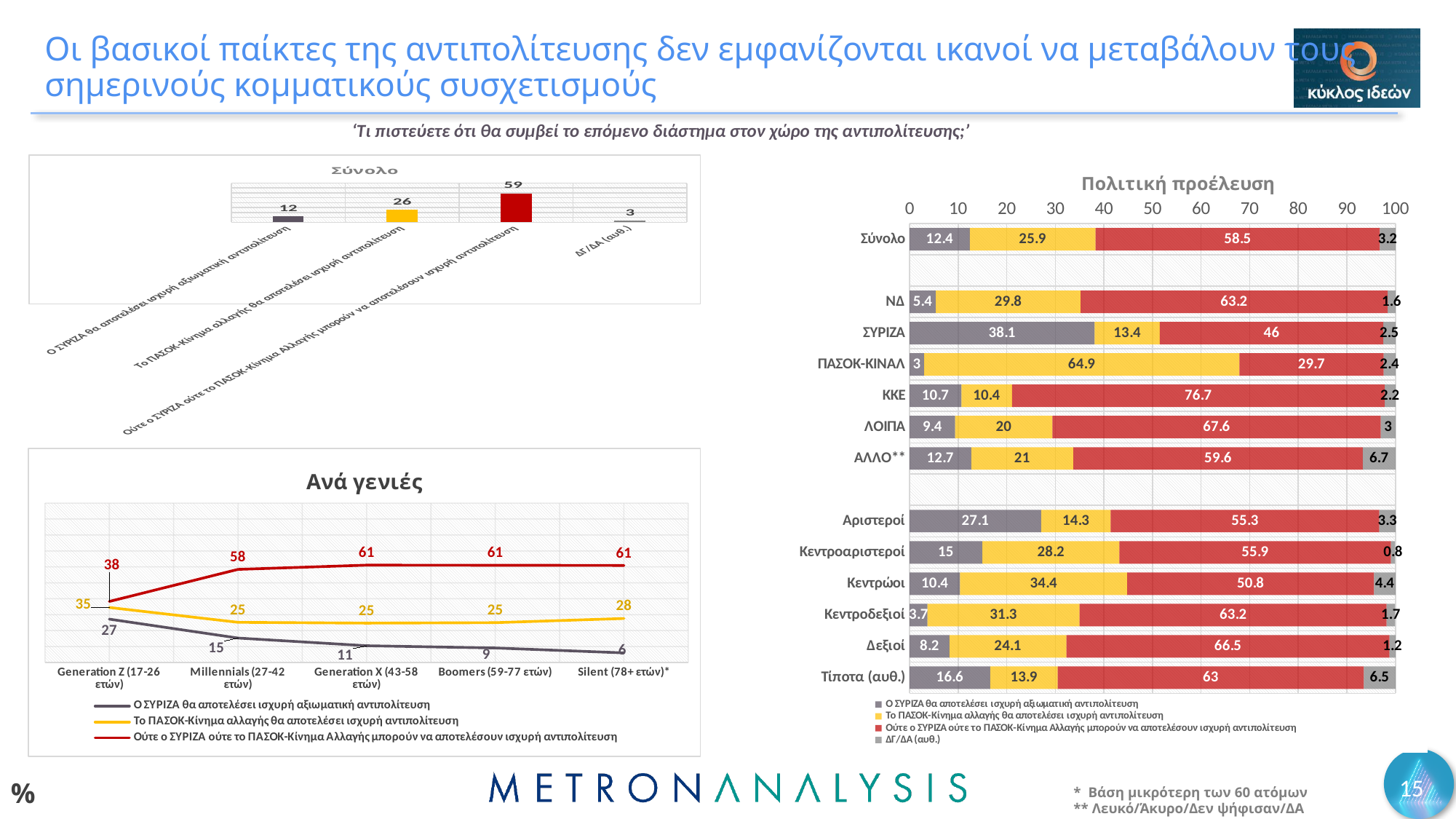
In the 'Ανά γενιές' chart, what is the difference between the red series and the yellow series for Silent (78+ ετών)? 33 In the 'Πολιτική προέλευση' chart, which has the larger yellow segment, ΠΑΣΟΚ-ΚΙΝΑΛ or ΝΔ? ΠΑΣΟΚ-ΚΙΝΑΛ In the 'Σύνολο' chart, what is the value for ΔΓ/ΔΑ (αυθ.)? 3 In the 'Σύνολο' chart, what kind of chart is it? Bar chart In the 'Σύνολο' chart, which category has the highest value? Ούτε ο ΣΥΡΙΖΑ ούτε το ΠΑΣΟΚ-Κίνημα Αλλαγής μπορούν να αποτελέσουν ισχυρή αντιπολίτευση In the 'Πολιτική προέλευση' chart, what is the value of the red segment for ΚΚΕ? 76.7 In the 'Πολιτική προέλευση' chart, how many category bars are shown? 13 In the 'Ανά γενιές' chart, how many series does the legend list? 3 In the 'Ανά γενιές' chart, does the 'Ο ΣΥΡΙΖΑ θα αποτελέσει ισχυρή αξιωματική αντιπολίτευση' series rise or fall from Generation Z to Silent? Fall In the 'Ανά γενιές' chart, what kind of chart is it? Line chart In the 'Ανά γενιές' chart, what is the value of the 'Ο ΣΥΡΙΖΑ θα αποτελέσει ισχυρή αξιωματική αντιπολίτευση' series for Boomers (59-77 ετών)? 9 In the 'Πολιτική προέλευση' chart, what is the value of the 'Ο ΣΥΡΙΖΑ θα αποτελέσει ισχυρή αξιωματική αντιπολίτευση' segment for ΣΥΡΙΖΑ? 38.1